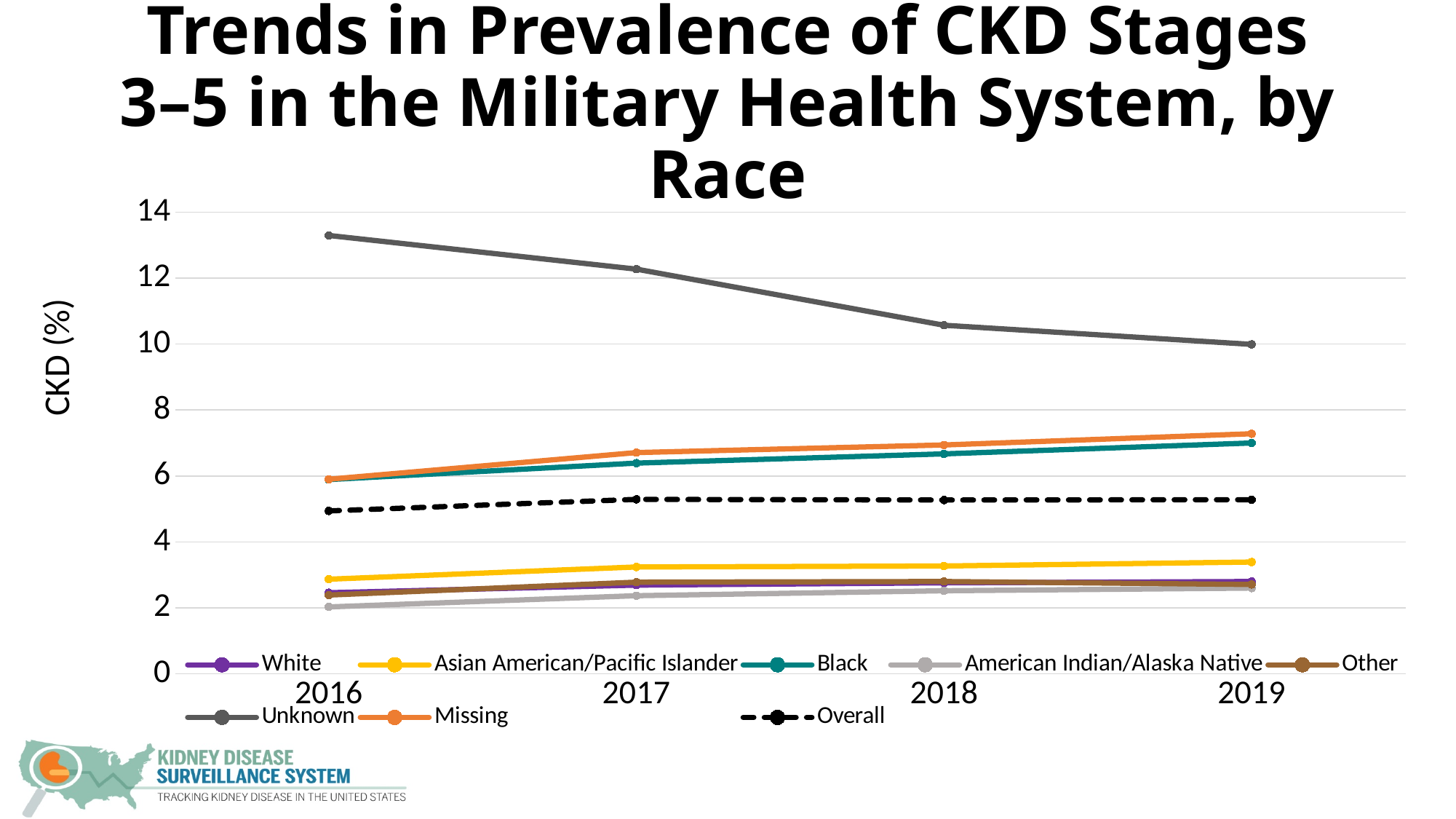
Is the value for Unknown in 2016 greater or less than 12? greater Does the CKD prevalence for the Black series rise or fall from 2016 to 2019? rise Which series has the highest CKD prevalence in 2016? Unknown Is the value for Unknown in 2019 greater or less than 12? less Which series is drawn with a dashed line? Overall What kind of chart is shown on the slide? line chart Does the CKD prevalence for the Unknown series rise or fall from 2016 to 2019? fall In 2018, which is larger: the value for Black or the value for Overall? Black Is the value for Overall in 2019 greater or less than 6? less How many series does the legend list? 8 Which series has the lowest CKD prevalence in 2016? American Indian/Alaska Native How many years are shown on the x axis? 4